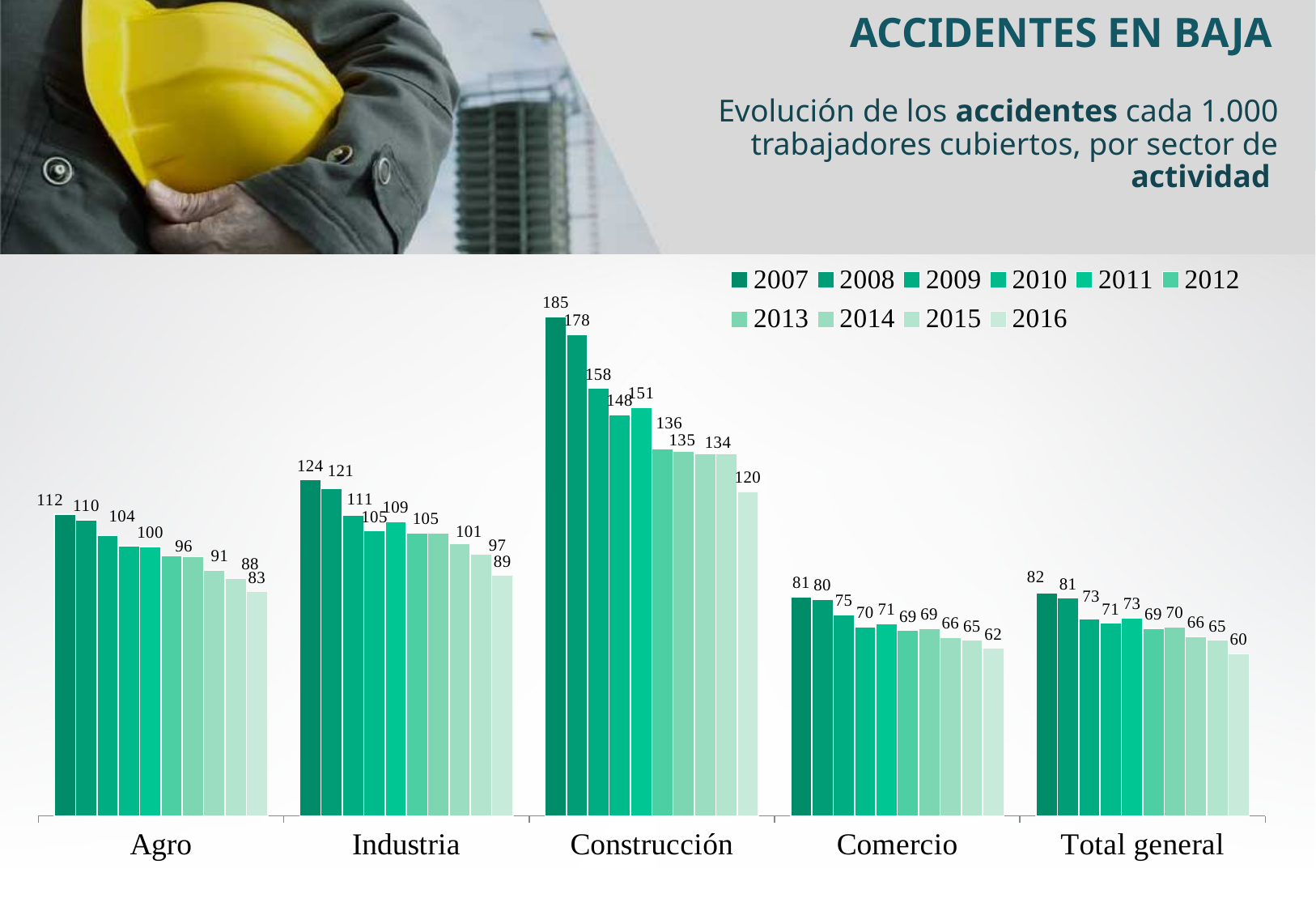
Which is larger in 2007, the value for Industria or the value for Agro? Industria Which sector has the lowest value in 2007? Comercio What is the value for Agro in 2007? 112 How many sector categories are shown on the x axis? 5 What kind of chart is shown on the slide? bar chart How many series (years) does the legend list? 10 What is the value for Comercio in 2007? 81 Do the values for Comercio rise or fall from 2007 to 2016? fall What is the difference between the Construcción values for 2007 and 2016? 65 What is the value for Construcción in 2016? 120 What is the value for Total general in 2016? 60 Which sector has the highest value in 2007? Construcción